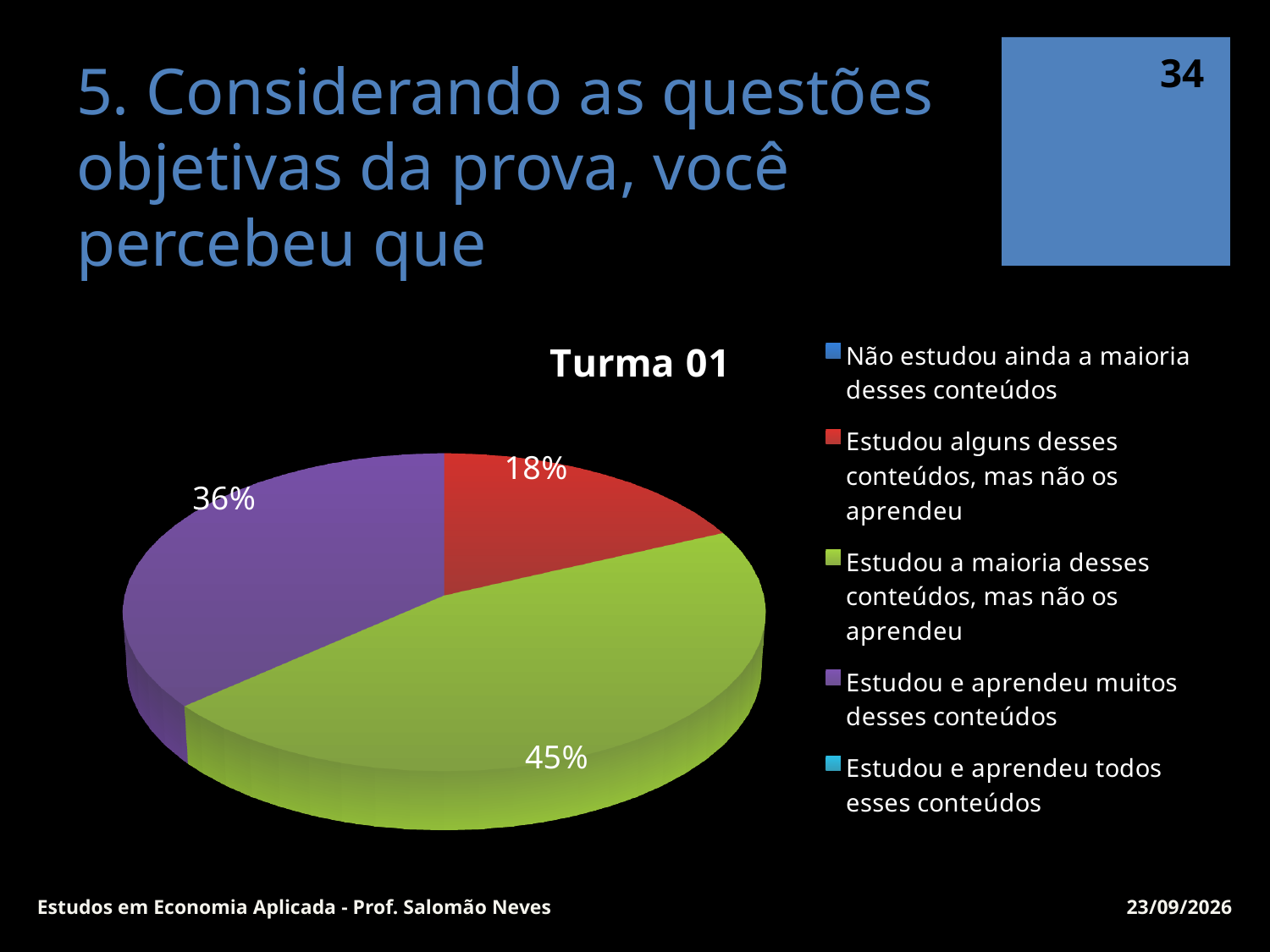
How many categories does the legend list? 5 What percentage of the pie corresponds to 'Estudou alguns desses conteúdos, mas não os aprendeu'? 18% What is the title of the chart? Turma 01 How many percentage points larger is the 'Estudou a maioria desses conteúdos, mas não os aprendeu' slice than the 'Estudou e aprendeu muitos desses conteúdos' slice? 9 percentage points What is the difference between the 36% slice and the 18% slice? 18 percentage points What percentage of the pie corresponds to 'Estudou a maioria desses conteúdos, mas não os aprendeu'? 45% What colour is the slice labelled 45%? Green What kind of chart is shown on the slide? Pie chart Which category has the largest slice of the pie? Estudou a maioria desses conteúdos, mas não os aprendeu Which of the labelled slices is the smallest? Estudou alguns desses conteúdos, mas não os aprendeu What percentage of the pie corresponds to 'Estudou e aprendeu muitos desses conteúdos'? 36% Which is larger: the slice for 'Estudou e aprendeu muitos desses conteúdos' or the slice for 'Estudou alguns desses conteúdos, mas não os aprendeu'? Estudou e aprendeu muitos desses conteúdos